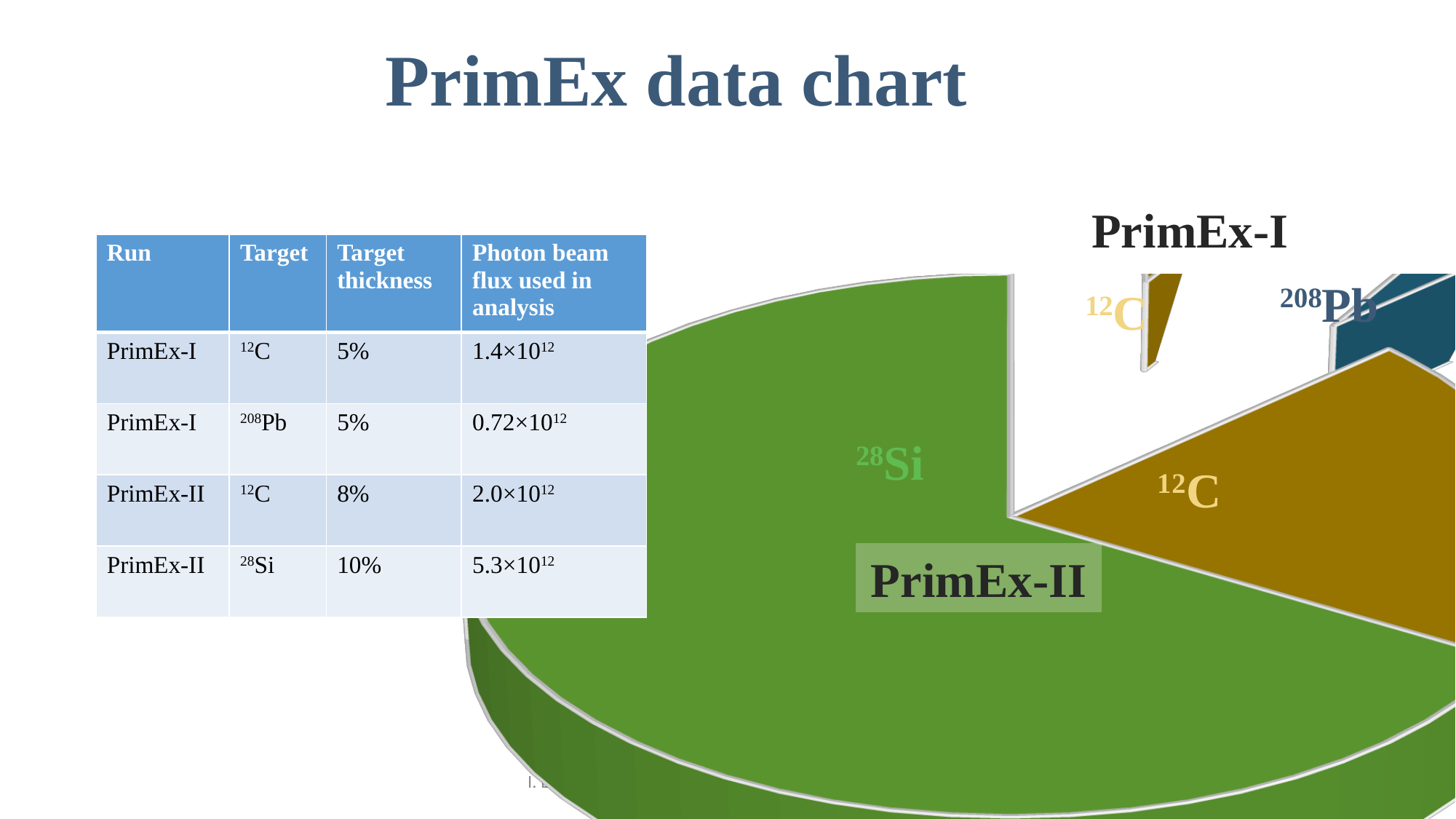
Which is larger in the pie chart, the 28Si slice or the 208Pb slice? 28Si Which slice of the pie chart is the smallest? 12C (PrimEx-I) What kind of chart is shown on the slide? pie chart What colour is the 28Si slice in the pie chart? green Which two run groups are labelled on the pie chart? PrimEx-I and PrimEx-II Which slice of the pie chart is the largest? 28Si How many slices does the pie chart show? 4 Which is larger in the pie chart, the PrimEx-II 12C slice or the PrimEx-I 12C slice? PrimEx-II 12C Which is larger in the pie chart, the 28Si slice or the PrimEx-II 12C slice? 28Si